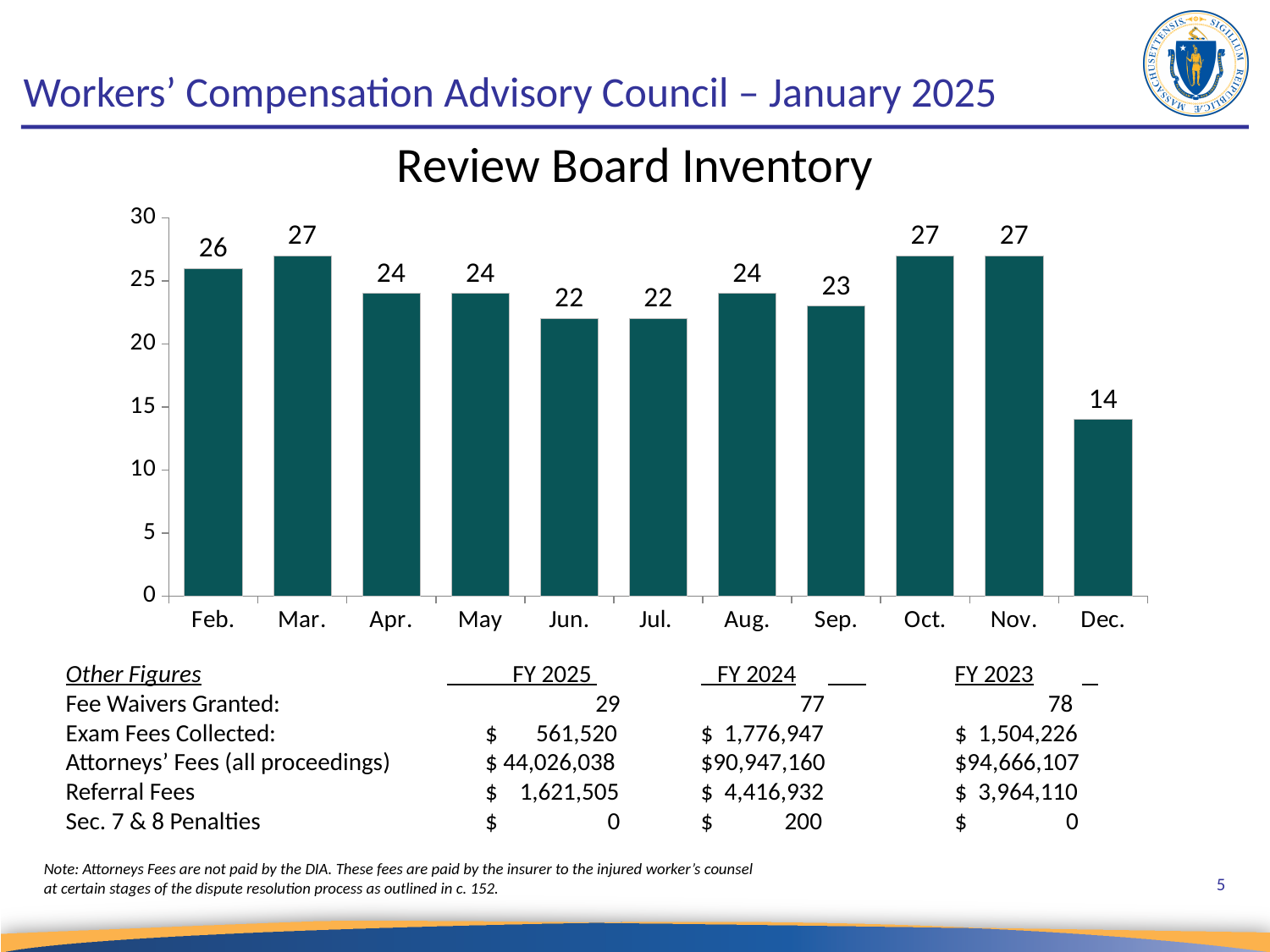
What kind of chart is the Review Board Inventory chart? bar chart What is the title of the chart on the slide? Review Board Inventory What is the difference between the Review Board Inventory for Nov. and Dec.? 13 What is the Review Board Inventory value for Feb.? 26 Which month has the lowest Review Board Inventory? Dec. Is the Review Board Inventory value for Dec. greater or less than 15? less What is the highest Review Board Inventory value shown on the chart? 27 How many months are shown on the Review Board Inventory chart? 11 Which is larger, the Review Board Inventory for Aug. or for Sep.? Aug. What is the Review Board Inventory value for Dec.? 14 What is the Review Board Inventory value for Sep.? 23 What is the difference between the Review Board Inventory for Mar. and Jun.? 5